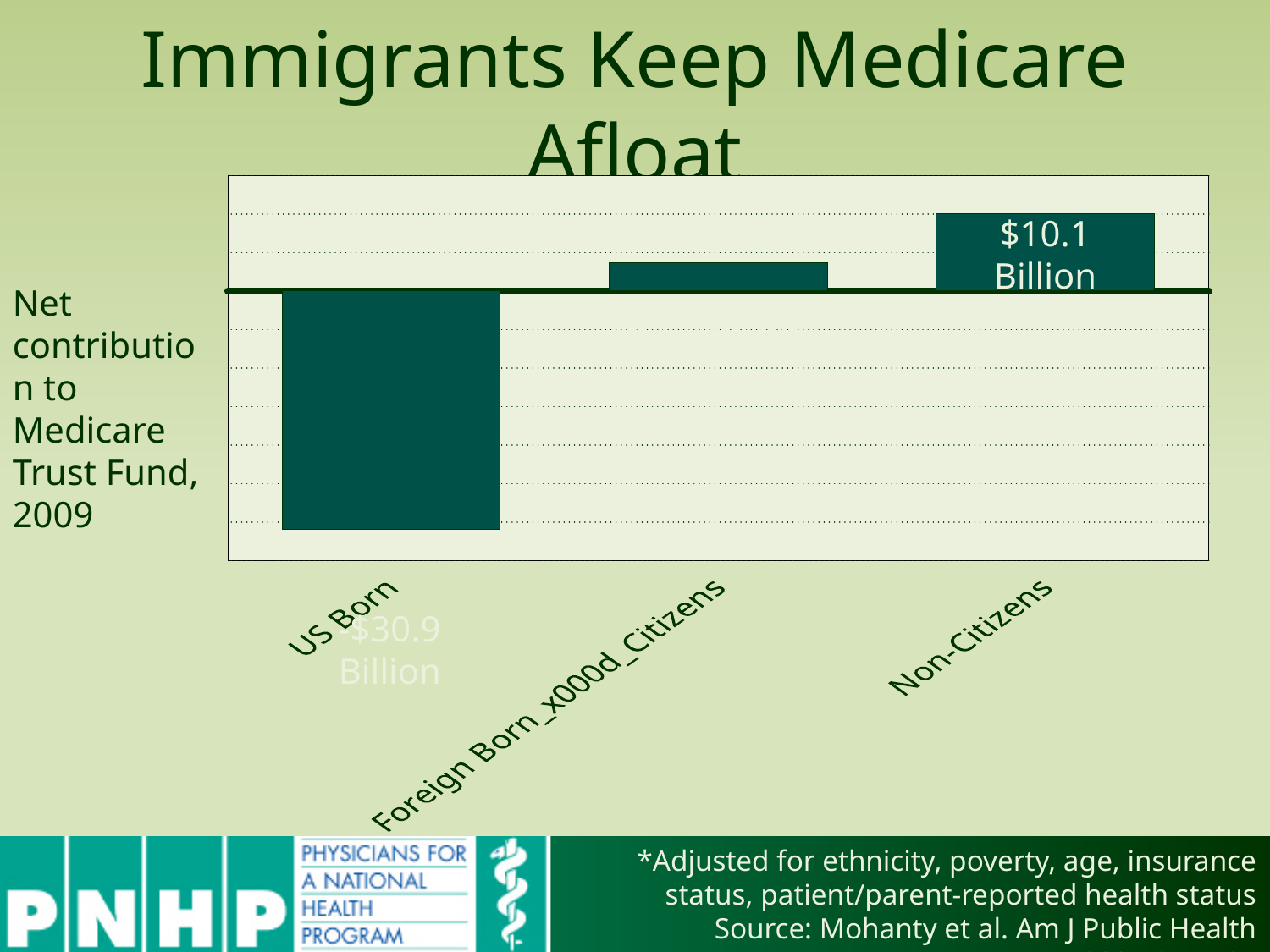
How many categories are plotted in the chart? 3 What is the difference between the Non-Citizens value ($10.1 Billion) and the US Born value (-$30.9 Billion)? $41.0 Billion Which is larger, the net contribution for US Born or for Non-Citizens? Non-Citizens Which is larger, the net contribution for Foreign Born Citizens or for Non-Citizens? Non-Citizens What is the title of the slide containing the chart? Immigrants Keep Medicare Afloat How many of the bars extend above the zero baseline? 2 What is the net contribution to the Medicare Trust Fund for US Born? -$30.9 Billion What kind of chart is shown on the slide? bar chart What does the label to the left of the chart say the bars measure? Net contribution to Medicare Trust Fund, 2009 Which category has the lowest net contribution to the Medicare Trust Fund? US Born What is the net contribution to the Medicare Trust Fund for Non-Citizens? $10.1 Billion Which category has the highest net contribution to the Medicare Trust Fund? Non-Citizens